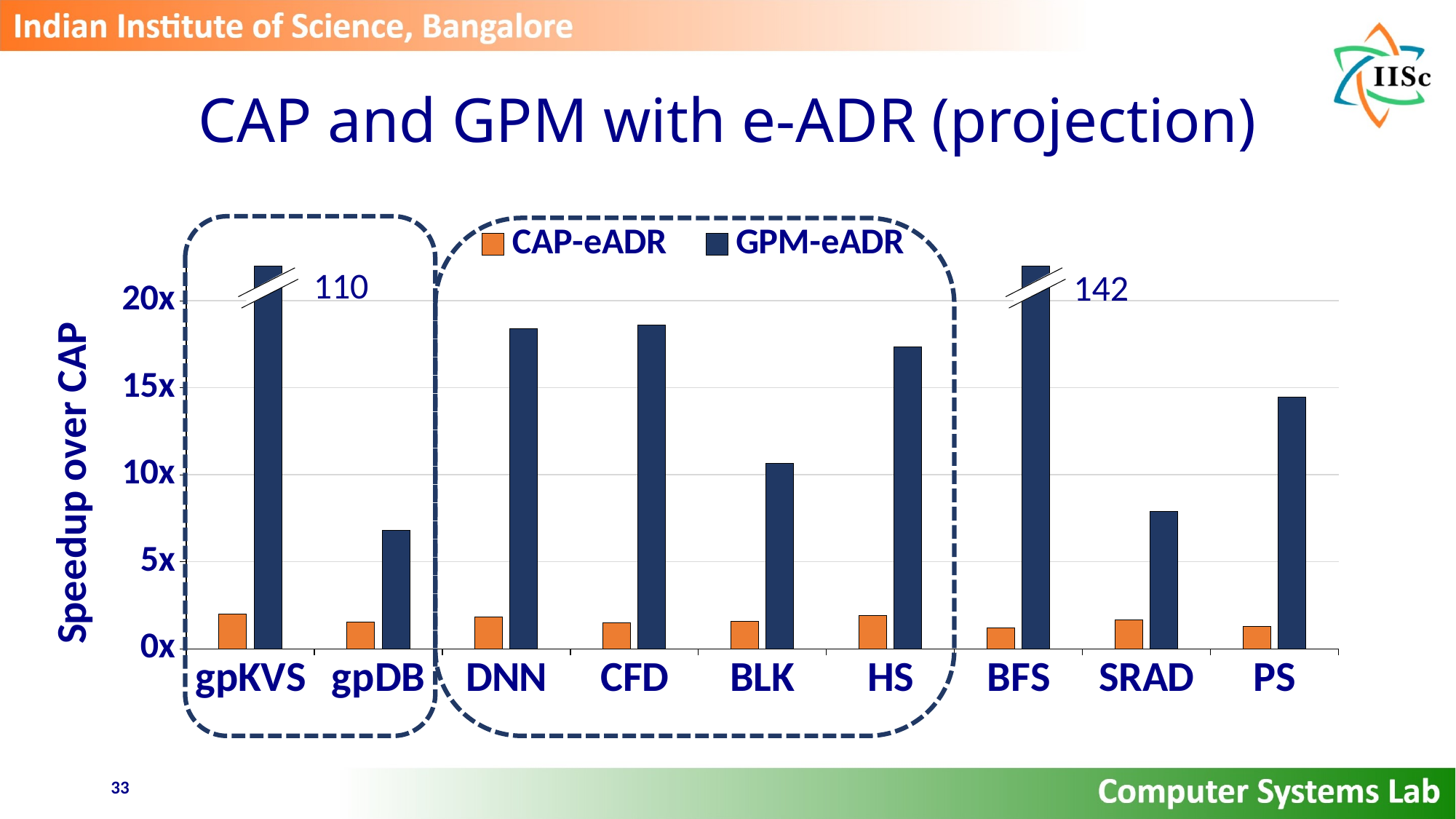
What is the GPM-eADR speedup value labelled for gpKVS? 110 Is the GPM-eADR value for DNN greater or less than 15x? greater What is the title of the y axis? Speedup over CAP How many categories are shown along the x axis? 9 Is the GPM-eADR value for gpDB greater or less than 10x? less Is the CAP-eADR value for HS greater or less than 5x? less What kind of chart is shown on the slide? bar chart What is the difference between the labelled GPM-eADR values for BFS and gpKVS? 32 How many series does the legend list? 2 Which is larger, the GPM-eADR value for gpKVS or for BFS? BFS Which category has the highest GPM-eADR speedup? BFS What is the GPM-eADR speedup value labelled for BFS? 142